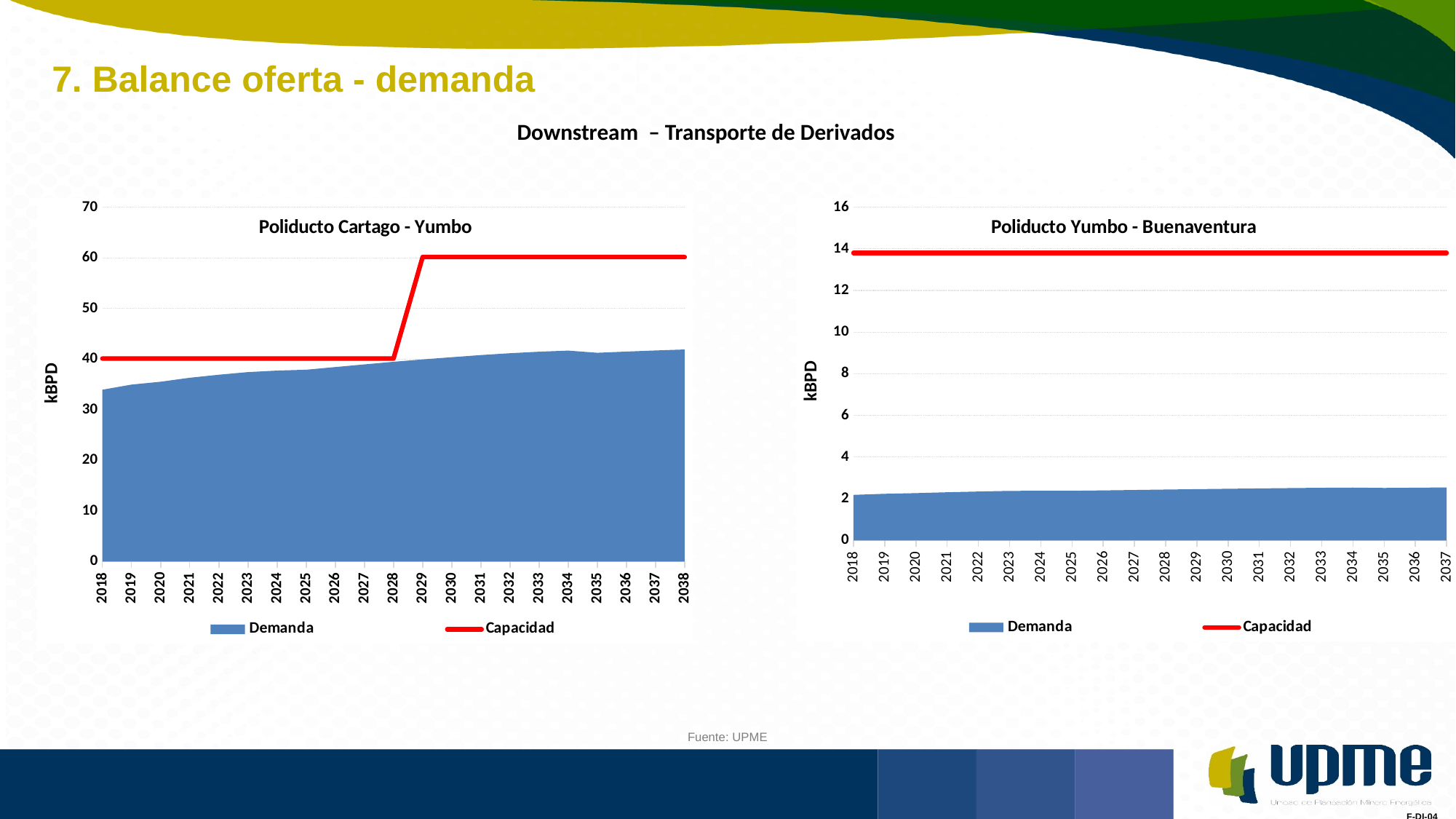
On the Poliducto Cartago - Yumbo chart, is the Demanda value for 2038 greater or less than 40? greater On the Poliducto Yumbo - Buenaventura chart, is the Capacidad value greater or less than 12? greater On the Poliducto Cartago - Yumbo chart, is the Demanda value for 2018 greater or less than 40? less How many years are shown on the x axis of the Poliducto Cartago - Yumbo chart? 21 On the Poliducto Cartago - Yumbo chart, which is larger in 2032, Demanda or Capacidad? Capacidad On the Poliducto Cartago - Yumbo chart, what is the Capacidad value in 2020? 40 On the Poliducto Cartago - Yumbo chart, what is the Capacidad value in 2035? 60 How many series does the legend of the Poliducto Yumbo - Buenaventura chart list? 2 On the Poliducto Cartago - Yumbo chart, does Demanda rise or fall from 2018 to 2038? rise How many years are shown on the x axis of the Poliducto Yumbo - Buenaventura chart? 20 On the Poliducto Cartago - Yumbo chart, in which year does the Capacidad line step up from 40 to 60? 2029